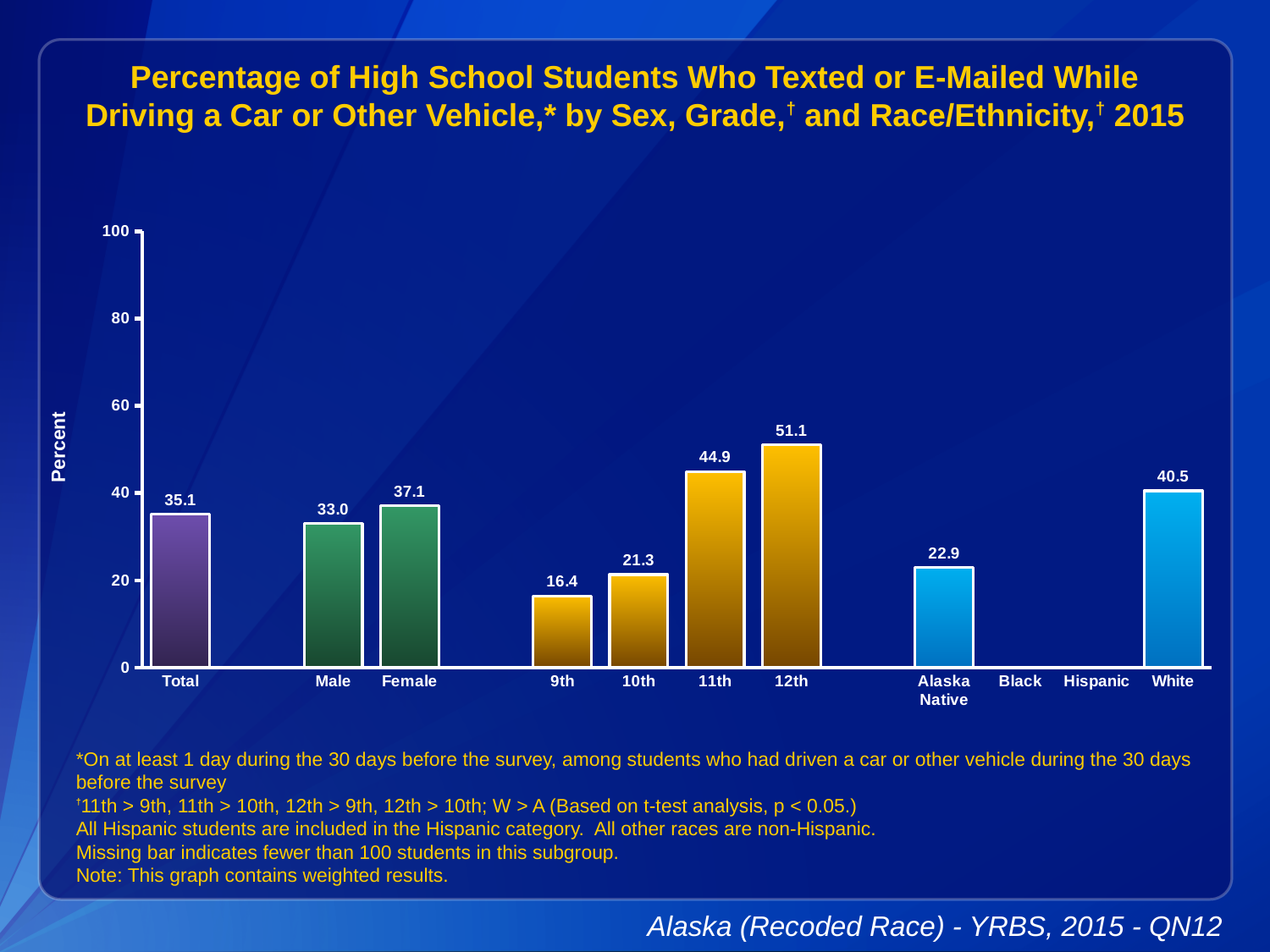
What is the value for 12th grade? 51.1 What kind of chart is this? bar chart Which is larger, the value for 11th grade or the value for White? 11th Is the value for 10th grade greater or less than 20? greater Which category has the lowest value? 9th What is the value for Alaska Native? 22.9 Which category has the highest value? 12th Do the values rise or fall from 9th grade to 12th grade? rise What is the difference between the values for Female and Male? 4.1 How many categories have a bar plotted? 9 What is the value for Total? 35.1 What is the value for Female? 37.1